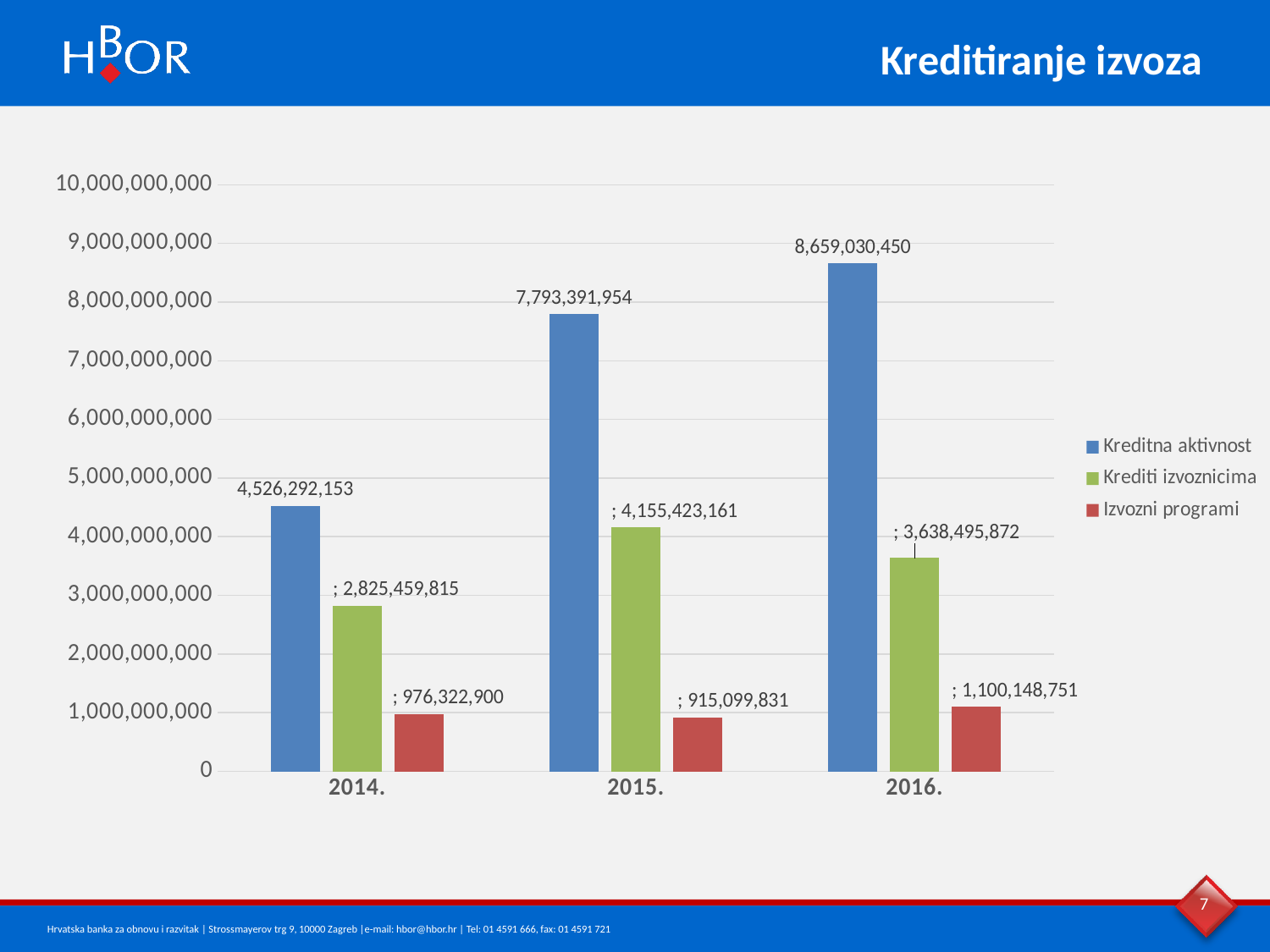
How many years are shown on the x axis? 3 How many series does the legend list? 3 What is the value of Kreditna aktivnost for 2016.? 8,659,030,450 Which is larger: Krediti izvoznicima in 2015. or in 2016.? 2015. What is the difference between Krediti izvoznicima in 2015. and in 2014.? 1,329,963,346 What is the value of Izvozni programi for 2015.? 915,099,831 Is the value of Kreditna aktivnost for 2014. greater or less than 5,000,000,000? less In which year is Izvozni programi lowest? 2015. In which year is Kreditna aktivnost highest? 2016. What is the difference between Kreditna aktivnost in 2016. and in 2015.? 865,638,496 What kind of chart is shown on the slide? bar chart What is the value of Krediti izvoznicima for 2014.? 2,825,459,815